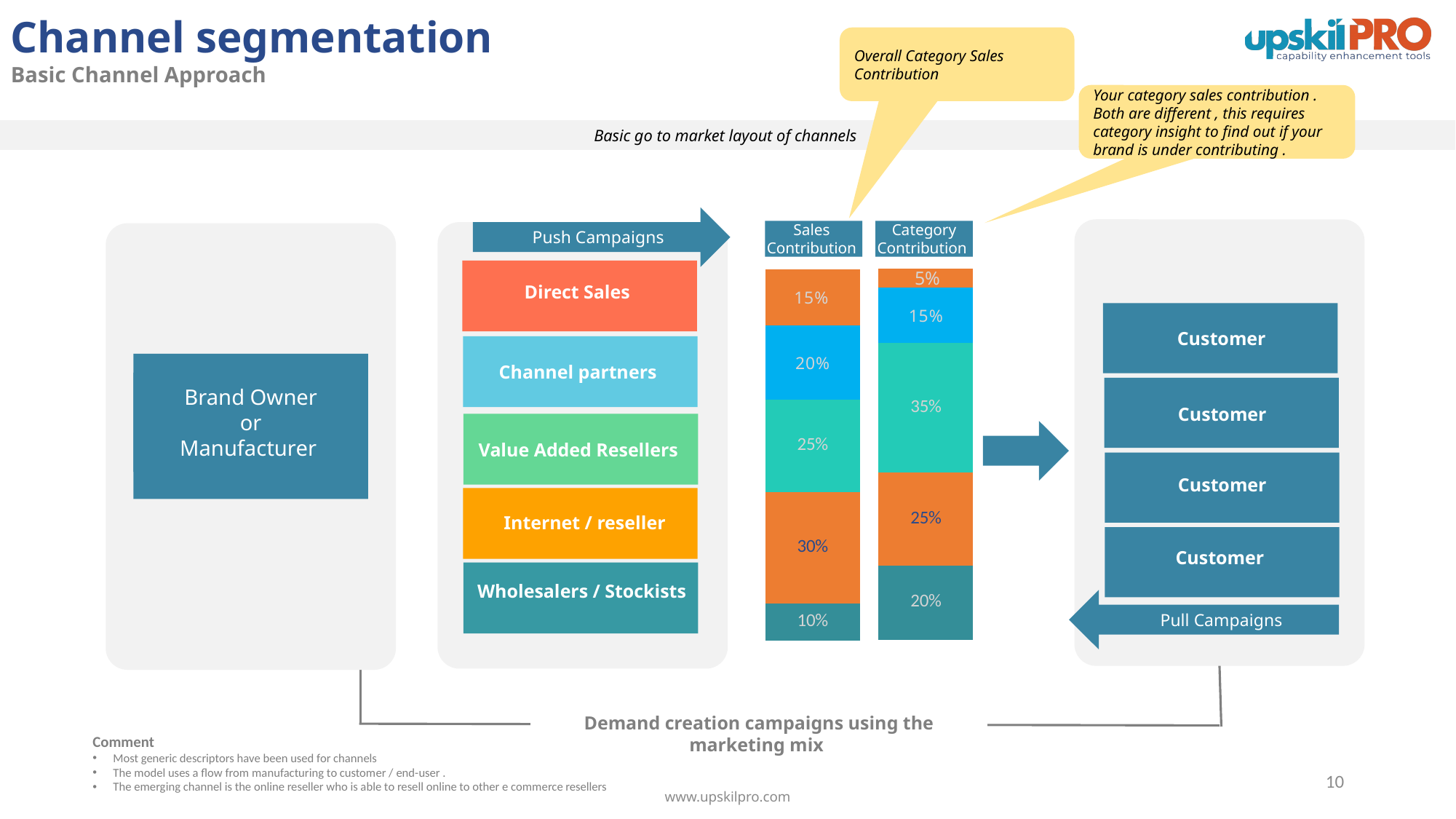
What kind of chart is used to show Sales Contribution and Category Contribution? Stacked bar chart Which bar has the larger bottom segment, Sales Contribution or Category Contribution? Category Contribution In the Sales Contribution stacked bar, what is the largest segment value? 30% How many segments does the Sales Contribution stacked bar contain? 5 In the Category Contribution stacked bar, what is the largest segment value? 35% In the Category Contribution stacked bar, what is the value of the bottom segment? 20% What is the total of all segments in the Sales Contribution stacked bar? 100% In the Category Contribution stacked bar, what is the value of the top segment? 5% What is the difference between the middle (green) segment of the Category Contribution bar and the middle (green) segment of the Sales Contribution bar? 10% In the Category Contribution stacked bar, what is the smallest segment value? 5% In the Sales Contribution stacked bar, what is the value of the top segment? 15% In the Sales Contribution stacked bar, what is the value of the bottom segment? 10%